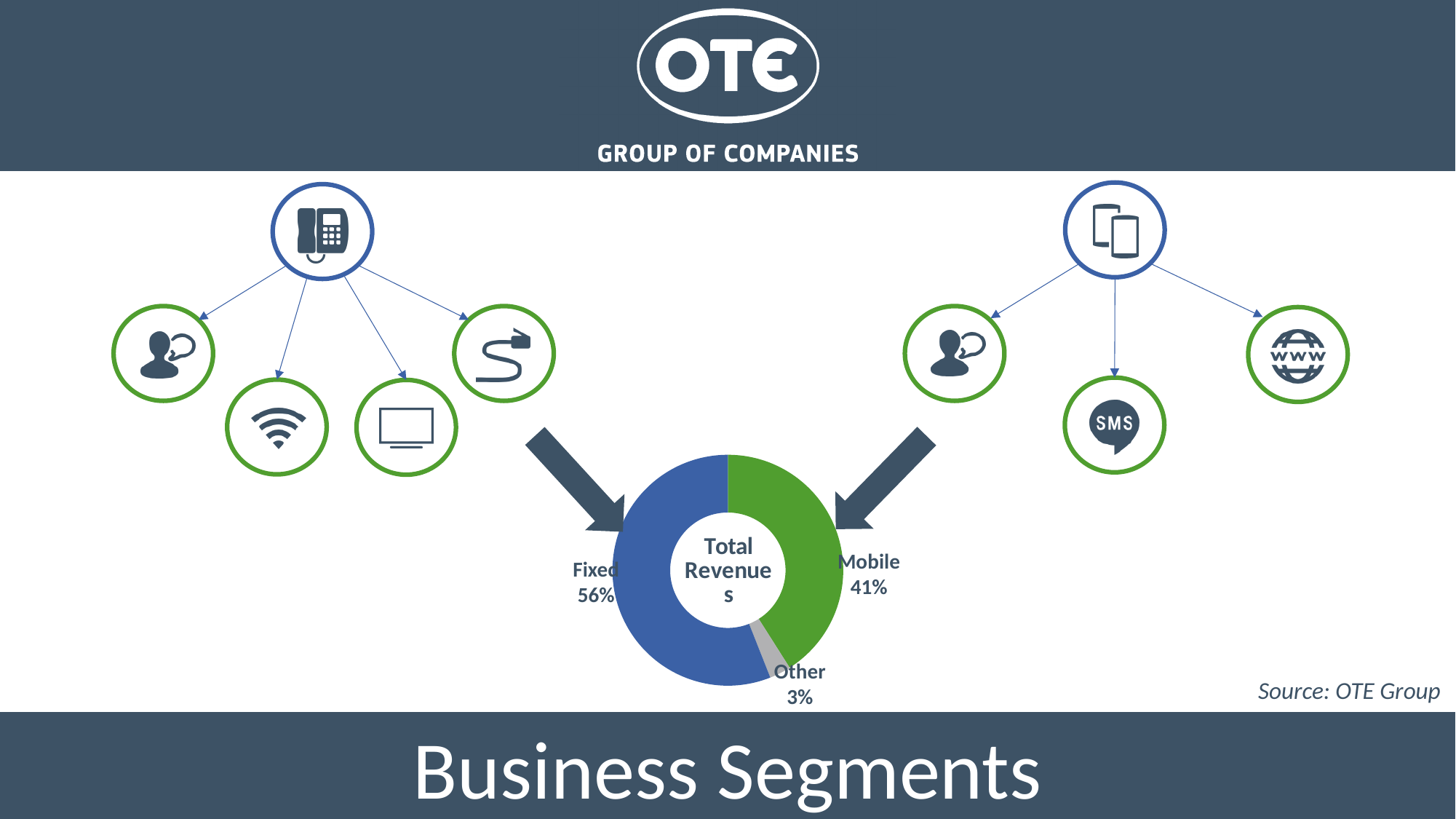
What share of Total Revenues does the Mobile segment account for? 41% What is the combined share of the Fixed and Mobile segments? 97% Which segment has the smallest share of Total Revenues? Other What colour is the Mobile slice of the chart? Green What label appears in the centre of the doughnut chart? Total Revenues How many segments are shown in the Total Revenues chart? 3 What share of Total Revenues does the Other segment account for? 3% Which is larger, the Mobile share or the Other share? Mobile What share of Total Revenues does the Fixed segment account for? 56% How many percentage points larger is the Fixed share than the Mobile share? 15 What kind of chart is used to show Total Revenues? Pie chart (doughnut) Which segment has the largest share of Total Revenues? Fixed